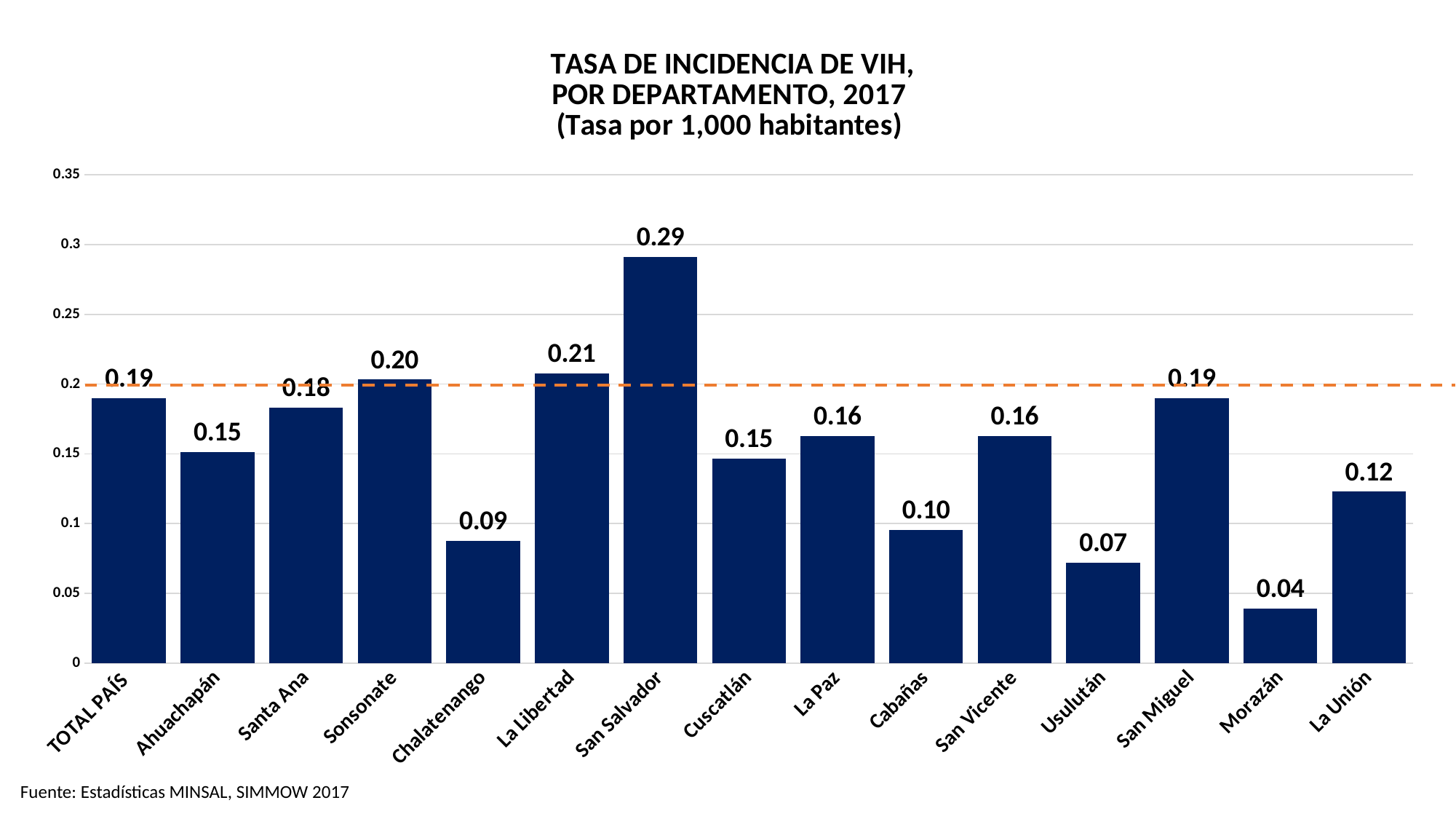
Which department has the lowest incidence rate? Morazán What is the difference between the values for San Salvador and Morazán? 0.25 Which department has the highest incidence rate? San Salvador What is the value shown for Morazán? 0.04 What is the HIV incidence rate for San Salvador? 0.29 How many bars are plotted in the chart? 15 Which is larger, the value for Sonsonate or the value for Cabañas? Sonsonate Is the value for Usulután greater or less than 0.1? less What is the source cited below the chart? Estadísticas MINSAL, SIMMOW 2017 What is the difference between the values for La Libertad and Chalatenango? 0.12 What kind of chart is shown on the slide? bar chart What is the value shown for TOTAL PAÍS? 0.19